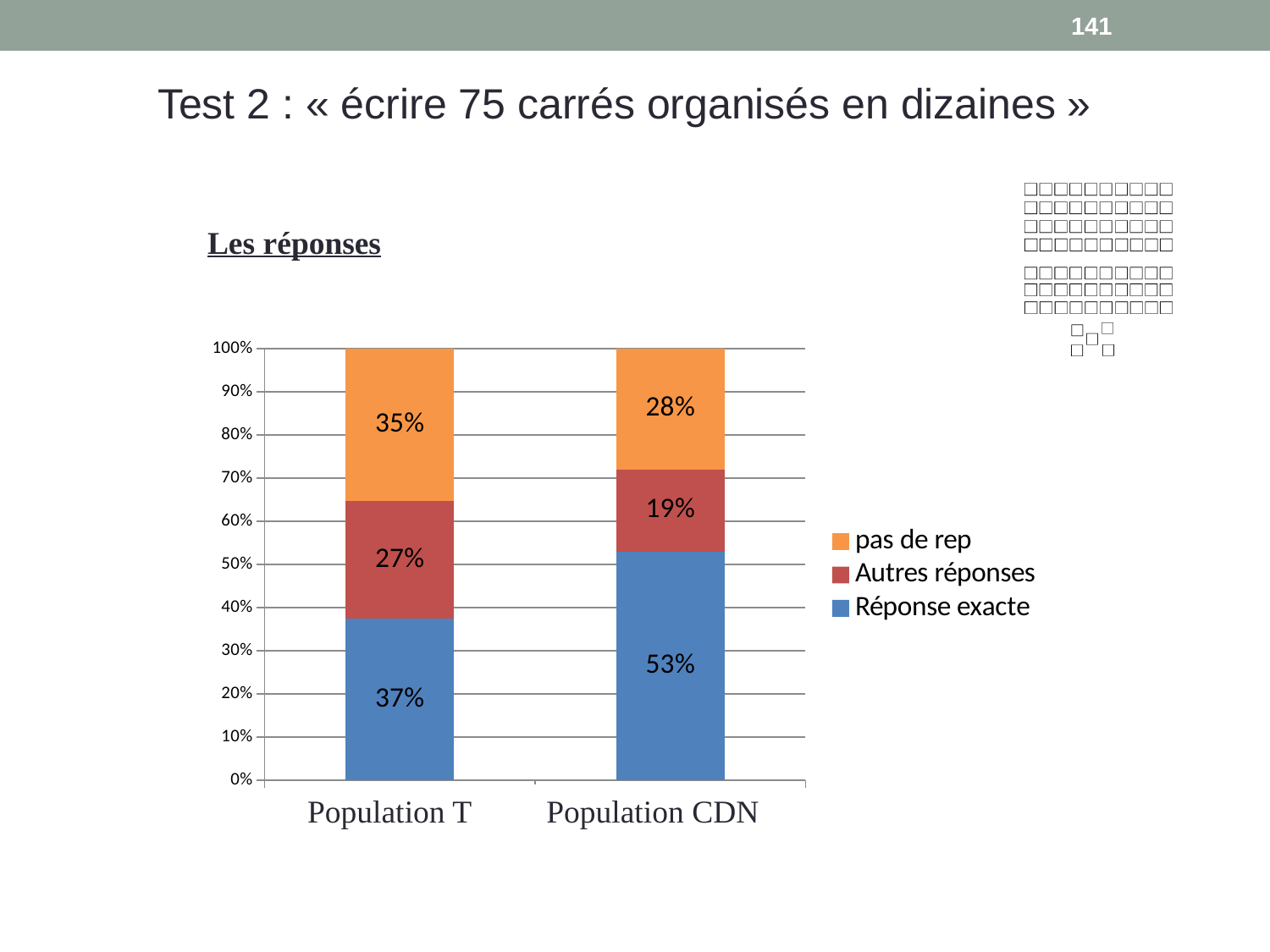
What is the difference between the Réponse exacte values for Population CDN and Population T? 16% Which population has the lower value for pas de rep? Population CDN What is the value for Autres réponses in Population T? 27% How many categories are shown on the x axis? 2 What is the value for Réponse exacte in Population CDN? 53% Is the value for Autres réponses larger in Population T or Population CDN? Population T Which series is shown in orange in the legend? pas de rep How many series does the legend list? 3 Which population has the higher value for Réponse exacte? Population CDN What is the value for Réponse exacte in Population T? 37% What kind of chart is shown? Stacked bar chart What is the value for pas de rep in Population CDN? 28%